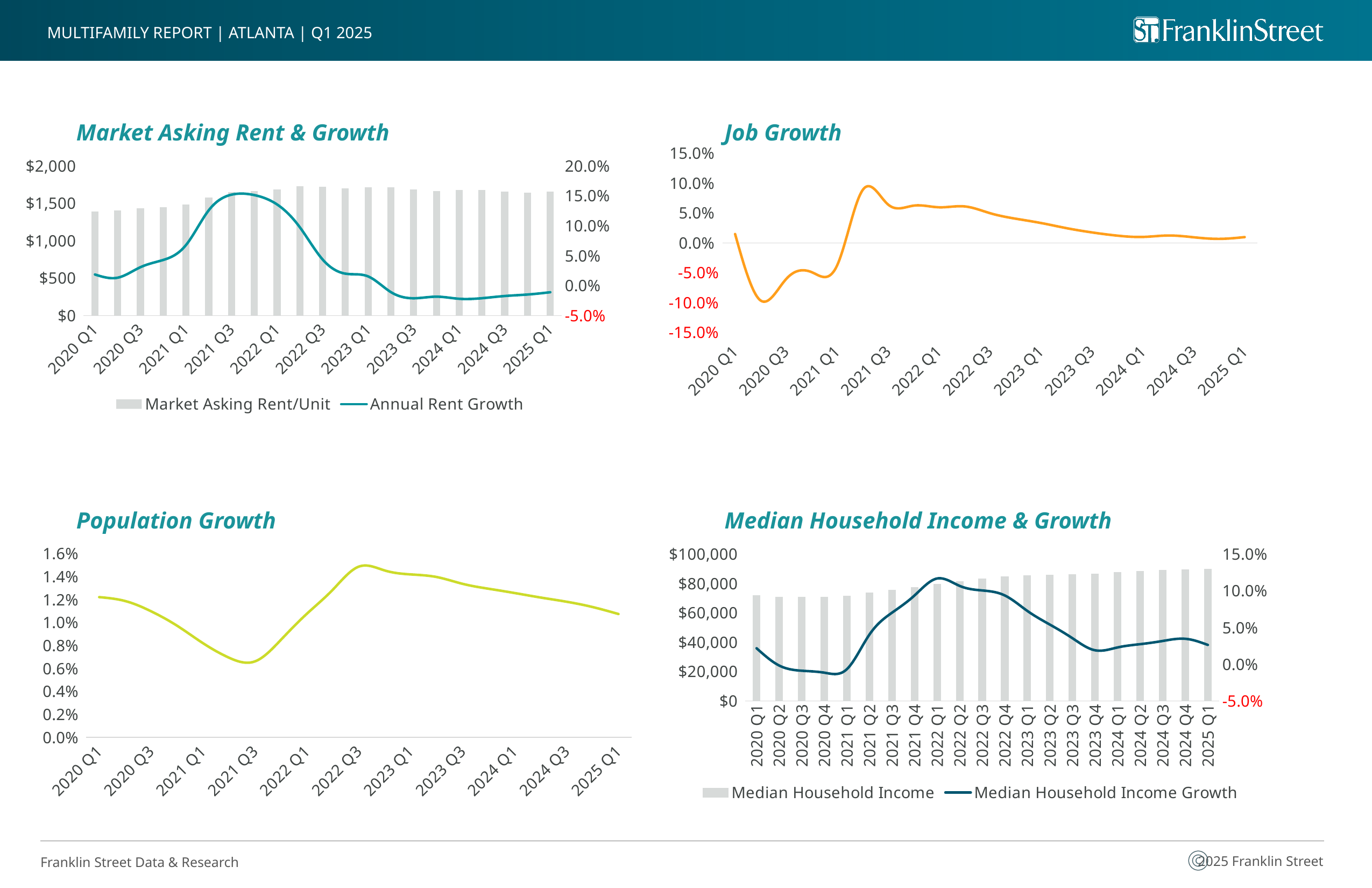
In the Market Asking Rent & Growth chart, is the Market Asking Rent/Unit bar for 2020 Q1 greater or less than $1,500? less In the Median Household Income & Growth chart, is the Median Household Income bar for 2025 Q1 greater or less than $80,000? greater How many series does the legend of the Market Asking Rent & Growth chart list? 2 What kind of chart is the Market Asking Rent & Growth chart? bar and line chart In the Population Growth chart, do the values rise or fall from 2022 Q3 to 2025 Q1? fall In the Population Growth chart, is the value for 2021 Q3 greater or less than 0.8%? less What kind of chart is the Job Growth chart? line chart What kind of chart is the Population Growth chart? line chart How many quarters are shown on the x axis of the Median Household Income & Growth chart? 21 What is the title of the chart in the top-right of the slide? Job Growth How many series does the legend of the Median Household Income & Growth chart list? 2